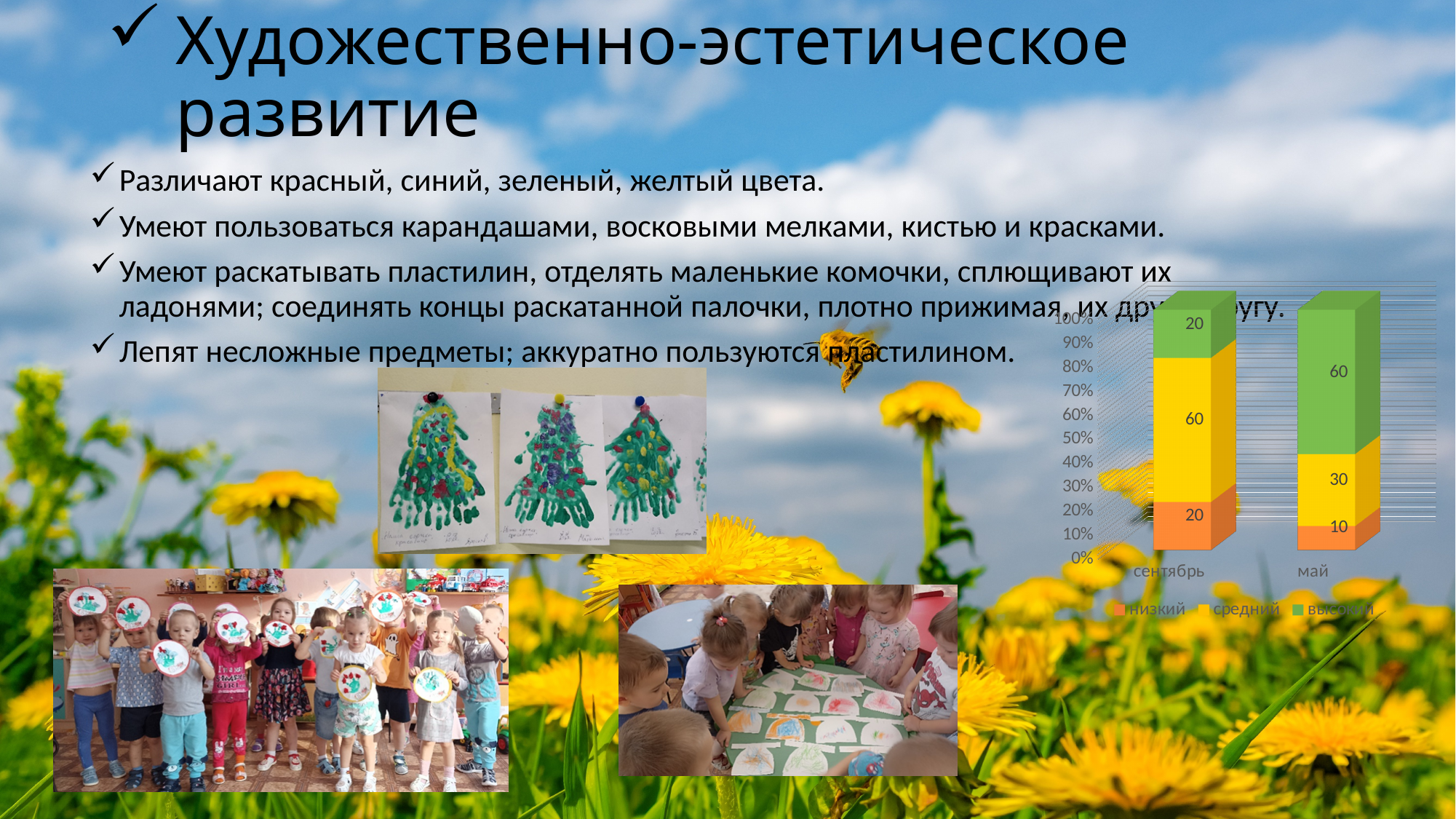
What is the total of the stacked bar for май? 100 What is the value of the высокий series for май? 60 What is the value of the низкий series for май? 10 What kind of chart is shown on the slide? stacked bar chart Does the низкий series rise or fall from сентябрь to май? fall What is the difference between the средний values for сентябрь and май? 30 Which category has the higher value for the высокий series, сентябрь or май? май Which series is shown in green in the chart? высокий How many series does the chart legend list? 3 What is the value of the высокий series for сентябрь? 20 How many categories are shown on the x axis of the chart? 2 What is the value of the средний series for сентябрь? 60